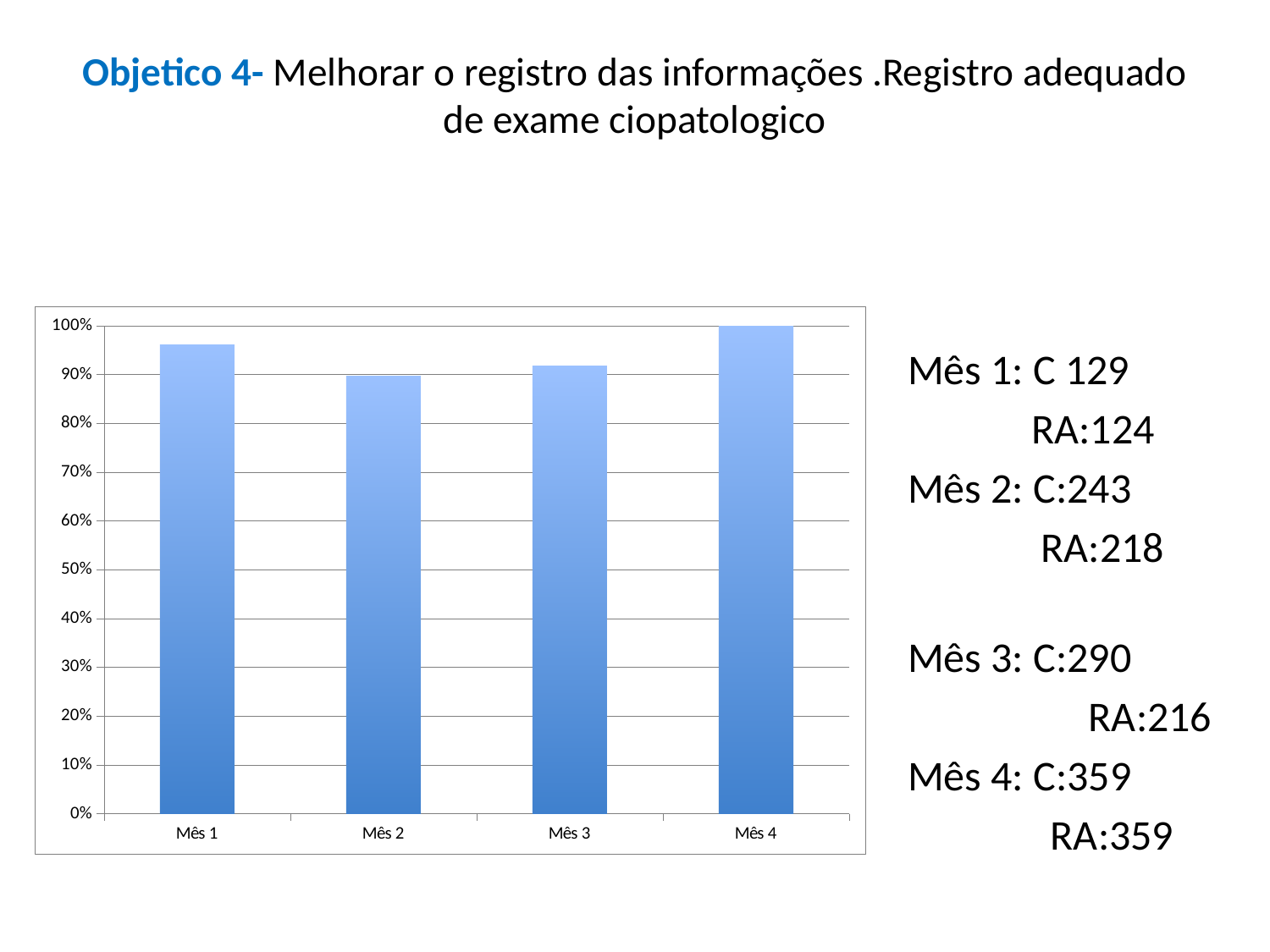
Is the value for Mês 1 greater or less than 100%? less Which month has the highest bar on the chart? Mês 4 What value does the bar for Mês 4 reach on the chart? 100% Which is larger, the value for Mês 1 or the value for Mês 3? Mês 1 What kind of chart is shown on the slide? bar chart What is the highest value shown on the chart's vertical axis? 100% Is the value for Mês 1 greater or less than 90%? greater Is the value for Mês 3 greater or less than 90%? greater Which is larger, the value for Mês 4 or the value for Mês 2? Mês 4 How many categories (months) are plotted on the chart? 4 Which month has the lowest bar on the chart? Mês 2